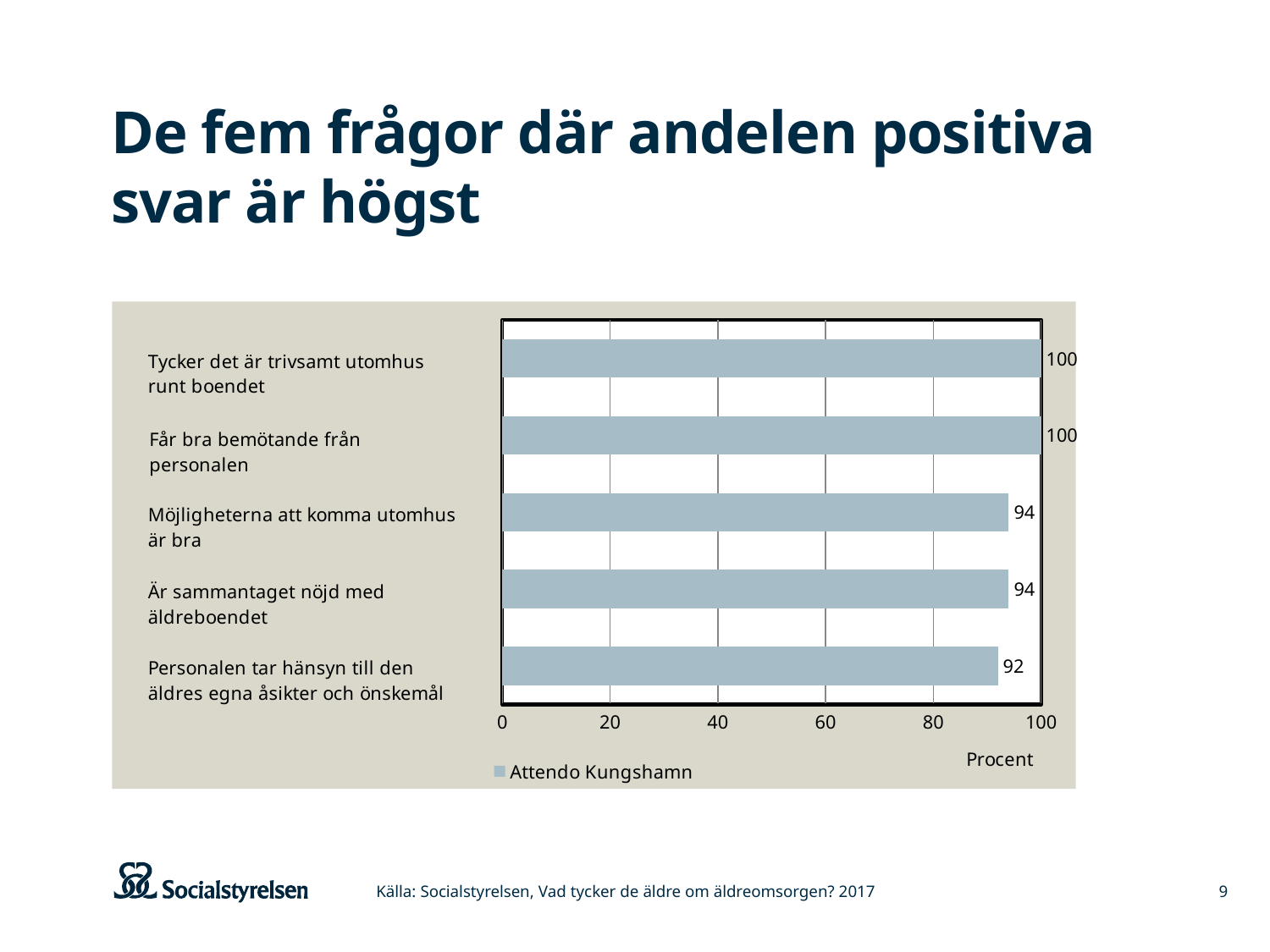
What is the difference between the value for "Får bra bemötande från personalen" and the value for "Personalen tar hänsyn till den äldres egna åsikter och önskemål"? 8 How many series does the legend list? 1 What is the value for "Personalen tar hänsyn till den äldres egna åsikter och önskemål"? 92 What is the value for "Möjligheterna att komma utomhus är bra"? 94 What is the value for "Tycker det är trivsamt utomhus runt boendet"? 100 How many categories are shown in the chart? 5 What is the label on the horizontal axis? Procent What is the series name shown in the legend? Attendo Kungshamn Which category has the lowest value? Personalen tar hänsyn till den äldres egna åsikter och önskemål Is the value for "Personalen tar hänsyn till den äldres egna åsikter och önskemål" greater or less than 80? greater What kind of chart is shown on the slide? bar chart Which is larger: the value for "Är sammantaget nöjd med äldreboendet" or the value for "Personalen tar hänsyn till den äldres egna åsikter och önskemål"? Är sammantaget nöjd med äldreboendet